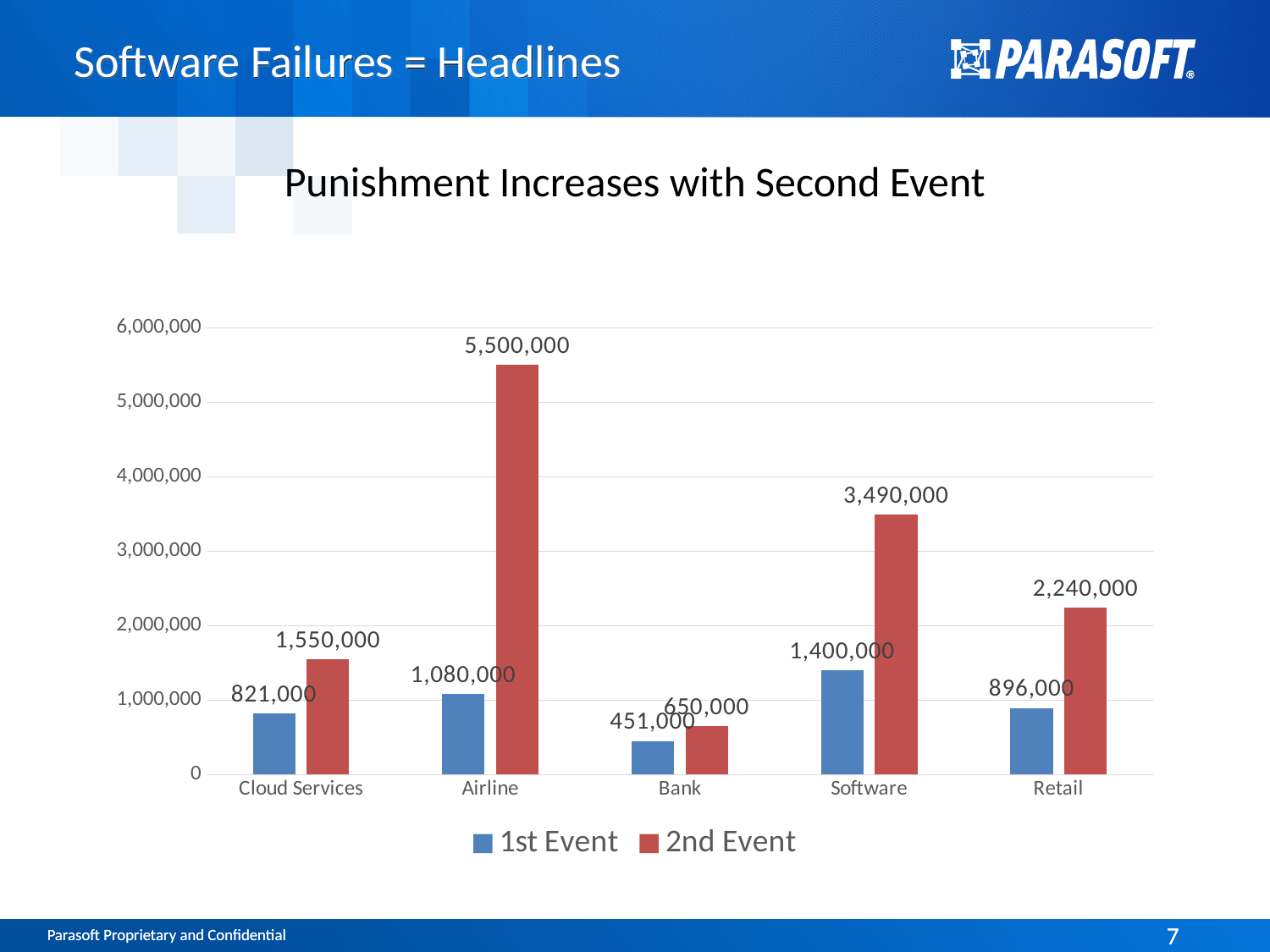
What kind of chart is shown on the slide? Bar chart Which category has the lowest 1st Event value? Bank Which is larger: the 1st Event value for Software or the 2nd Event value for Cloud Services? 2nd Event value for Cloud Services What is the 1st Event value for Bank? 451,000 What is the title of the chart? Punishment Increases with Second Event What is the 2nd Event value for Retail? 2,240,000 Which category has the highest 2nd Event value? Airline What is the 2nd Event value for Airline? 5,500,000 How many series does the legend list? 2 What is the 1st Event value for Software? 1,400,000 What is the difference between the 2nd Event and 1st Event values for Cloud Services? 729,000 How many categories are shown on the x axis? 5